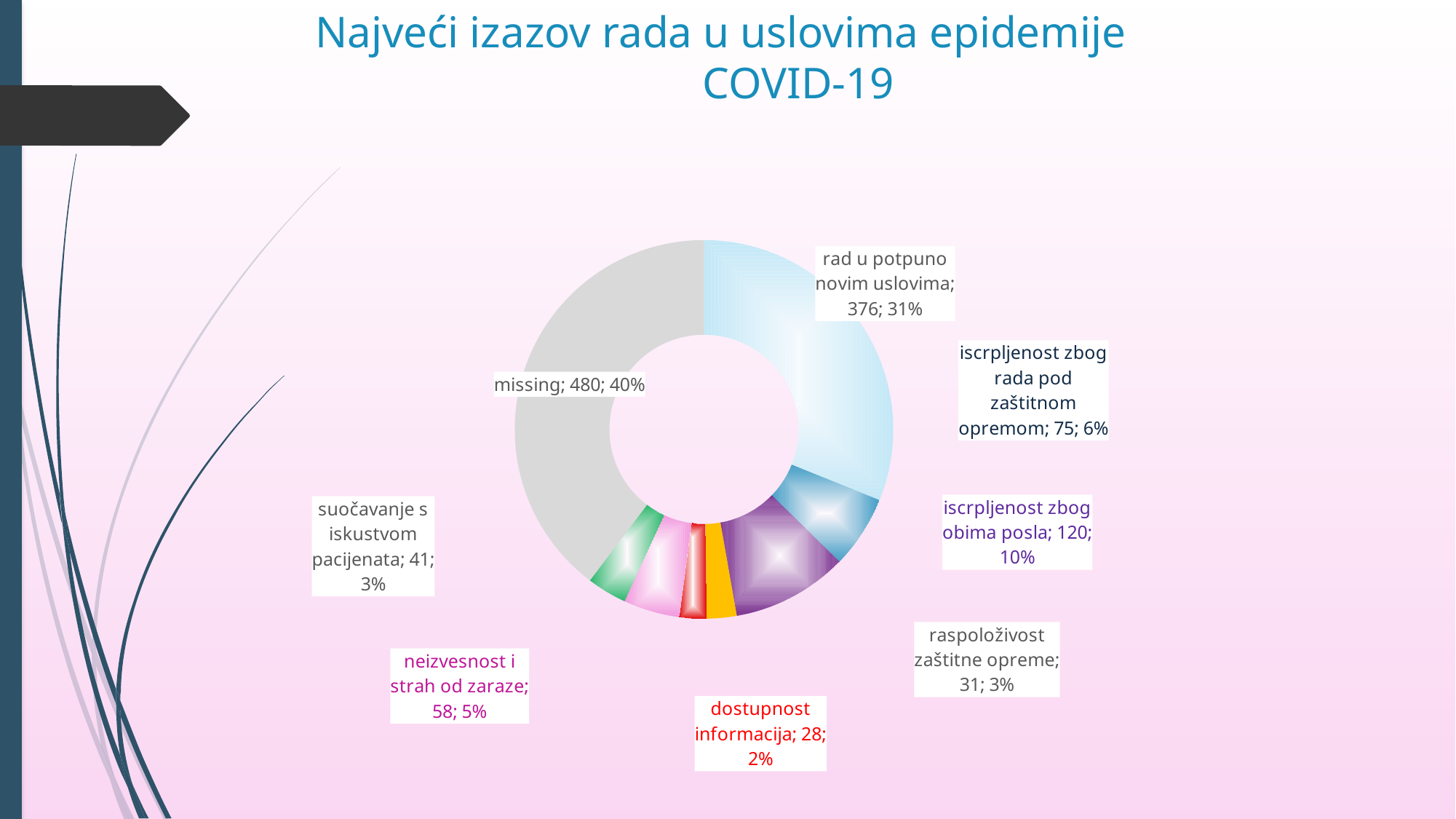
Which category has the largest slice? missing What percentage share does 'iscrpljenost zbog obima posla' have? 10% What is the title of the slide containing the chart? Najveći izazov rada u uslovima epidemije COVID-19 What is the value for 'raspoloživost zaštitne opreme'? 31 What is the value for 'neizvesnost i strah od zaraze'? 58 Which category has the smallest slice? dostupnost informacija What is the difference between the values for 'rad u potpuno novim uslovima' and 'iscrpljenost zbog obima posla'? 256 What is the value for 'rad u potpuno novim uslovima'? 376 How many categories (slices) does the chart show? 8 What kind of chart is shown on the slide? Doughnut (pie) chart Which is larger: the value for 'iscrpljenost zbog rada pod zaštitnom opremom' or for 'neizvesnost i strah od zaraze'? iscrpljenost zbog rada pod zaštitnom opremom What percentage share does 'missing' have? 40%